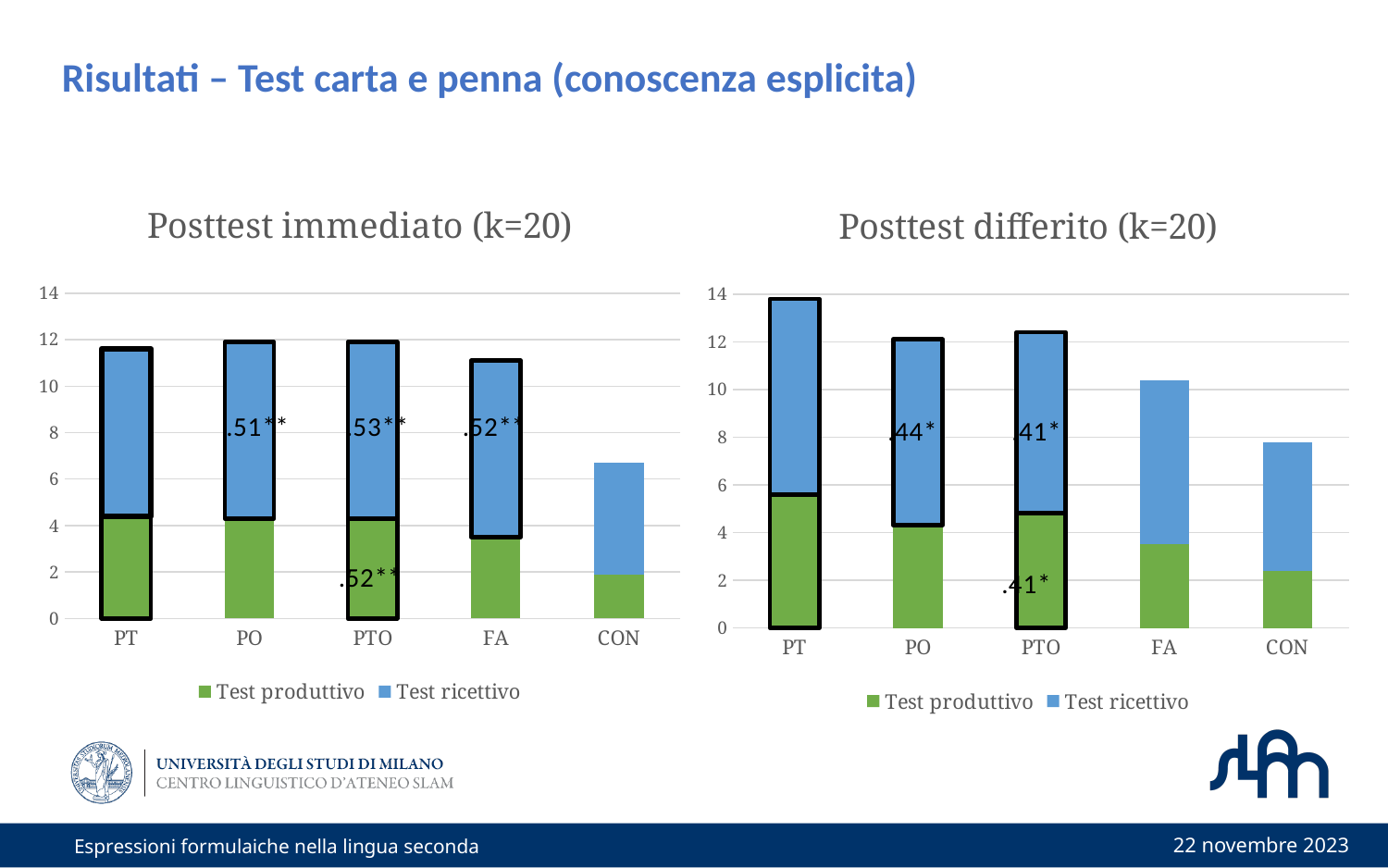
In the 'Posttest differito (k=20)' chart, which category has the largest 'Test produttivo' segment? PT How many series does the legend of the 'Posttest immediato (k=20)' chart list? 2 In the 'Posttest differito (k=20)' chart, which category has the lowest total bar? CON Which colour represents 'Test ricettivo' in the legend of the 'Posttest differito (k=20)' chart? Blue In the 'Posttest immediato (k=20)' chart, is the total bar for FA greater or less than 10? greater What kind of chart is the 'Posttest immediato (k=20)' chart? Stacked bar chart How many categories are shown on the x axis of the 'Posttest differito (k=20)' chart? 5 In the 'Posttest immediato (k=20)' chart, which category has the lowest total bar? CON In the 'Posttest immediato (k=20)' chart, is the total bar for CON greater or less than 6? greater In the 'Posttest differito (k=20)' chart, which category has the highest total bar? PT In the 'Posttest differito (k=20)' chart, is the total bar for PT greater or less than 12? greater In the 'Posttest differito (k=20)' chart, which total bar is larger, PT or CON? PT